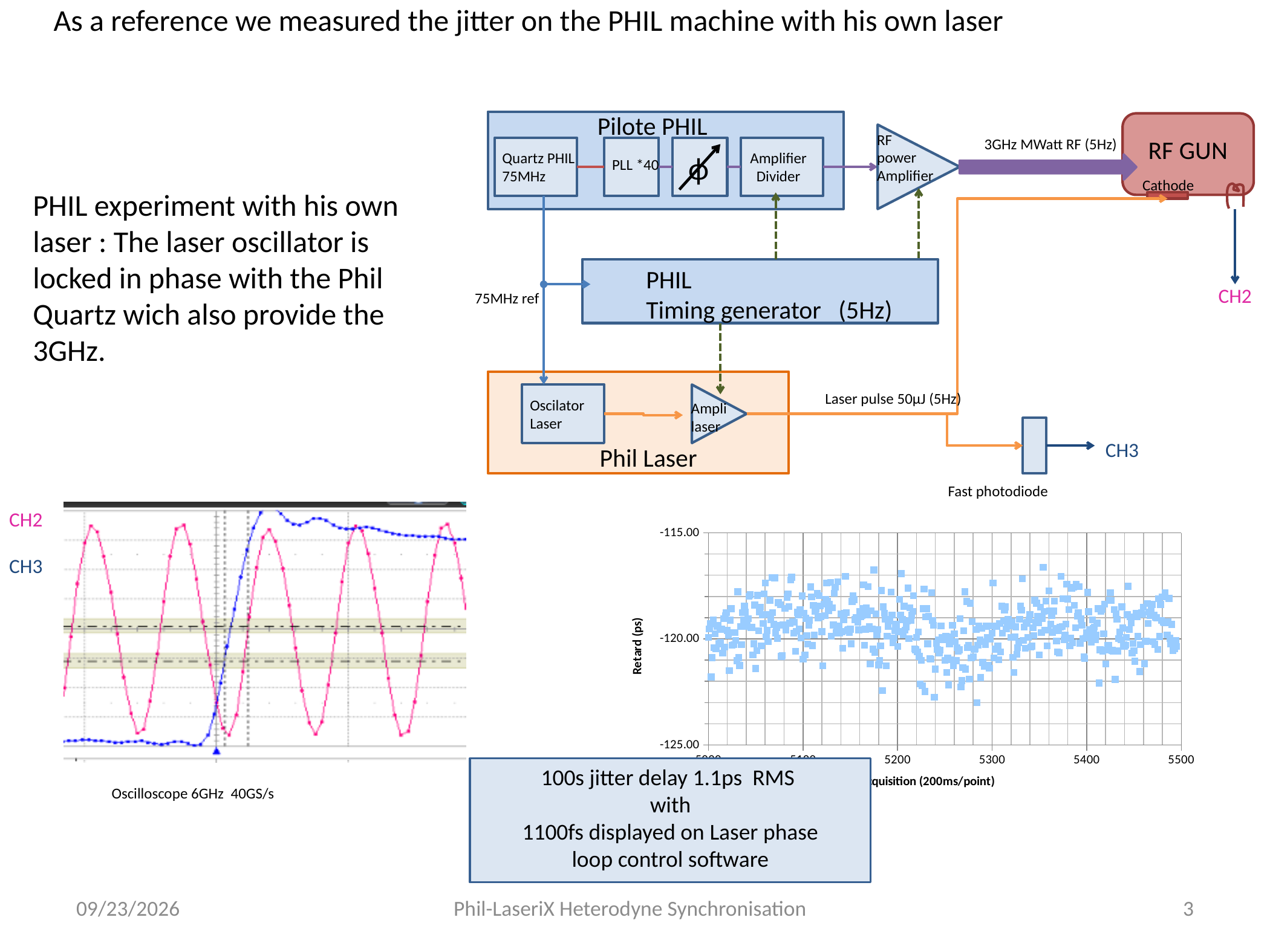
On the scatter chart on the lower right, are the plotted points mostly above or below the -115.00 gridline? below On the scatter chart on the lower right, what is the topmost tick value shown on the vertical axis? -115.00 On the scatter chart on the lower right, do the plotted values show a clear rising or falling trend along the x axis, or do they stay roughly flat? roughly flat On the scatter chart on the lower right, what is the rightmost tick value shown on the horizontal axis? 5500 On the scatter chart on the lower right, what colour are the plotted points? light blue On the scatter chart on the lower right, are the plotted points mostly above or below the -125.00 gridline? above On the scatter chart on the lower right, what is the bottommost tick value shown on the vertical axis? -125.00 What kind of chart is the chart on the lower right of the slide (Retard (ps) versus acquisition)? scatter chart On the scatter chart on the lower right, what is the label of the vertical axis? Retard (ps)